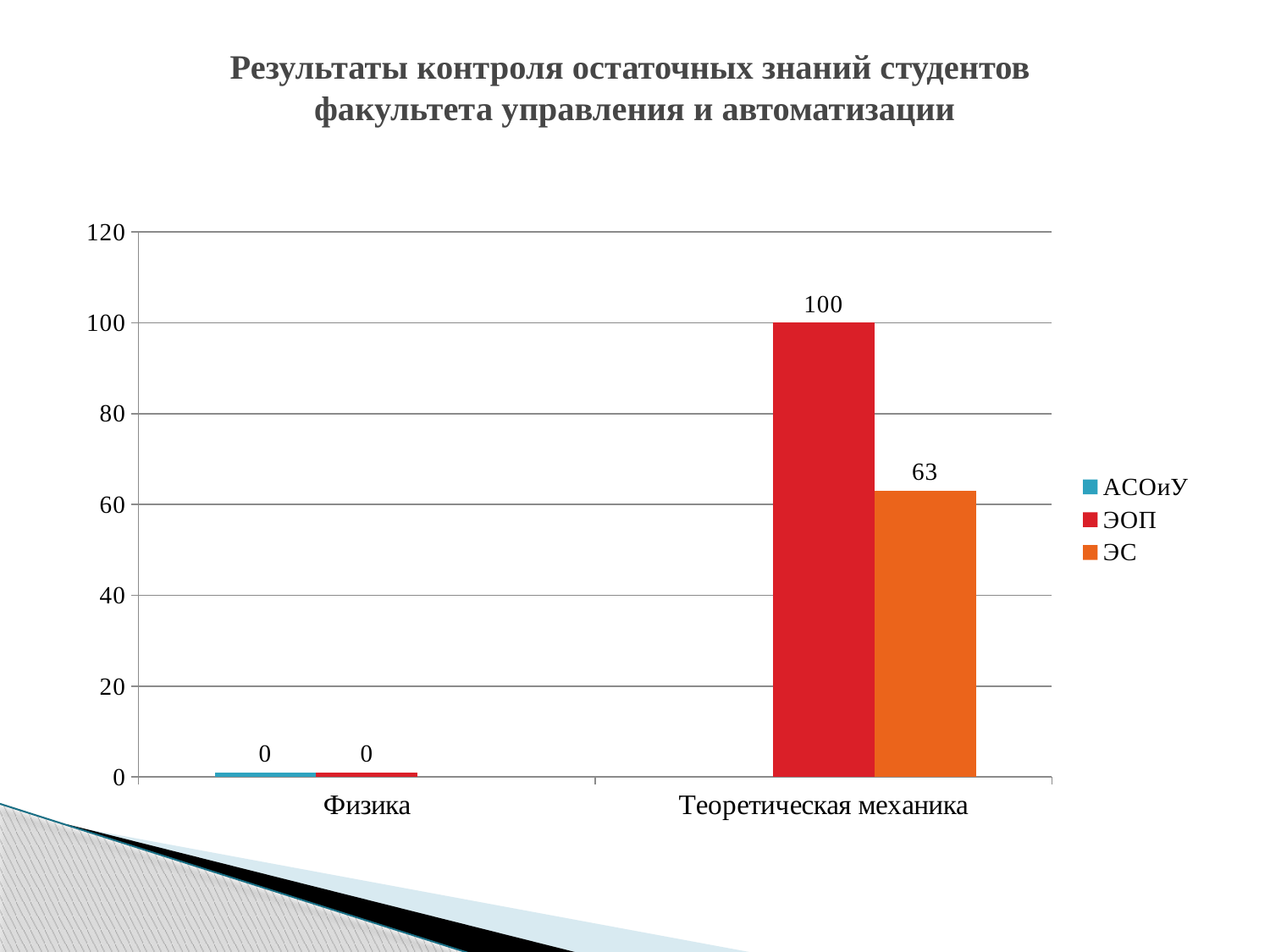
What colour are the ЭС bars? orange How many categories are shown on the x axis? 2 How many series does the legend list? 3 What is the value for ЭОП in Теоретическая механика? 100 What is the value for ЭОП in Физика? 0 What is the difference between the ЭОП and ЭС values in Теоретическая механика? 37 Which is larger in Теоретическая механика: ЭОП or ЭС? ЭОП What kind of chart is shown on the slide? bar chart Is the value for ЭС in Теоретическая механика greater or less than 80? less What is the value for ЭС in Теоретическая механика? 63 Which series has the highest value in Теоретическая механика? ЭОП What is the value for АСОиУ in Физика? 0